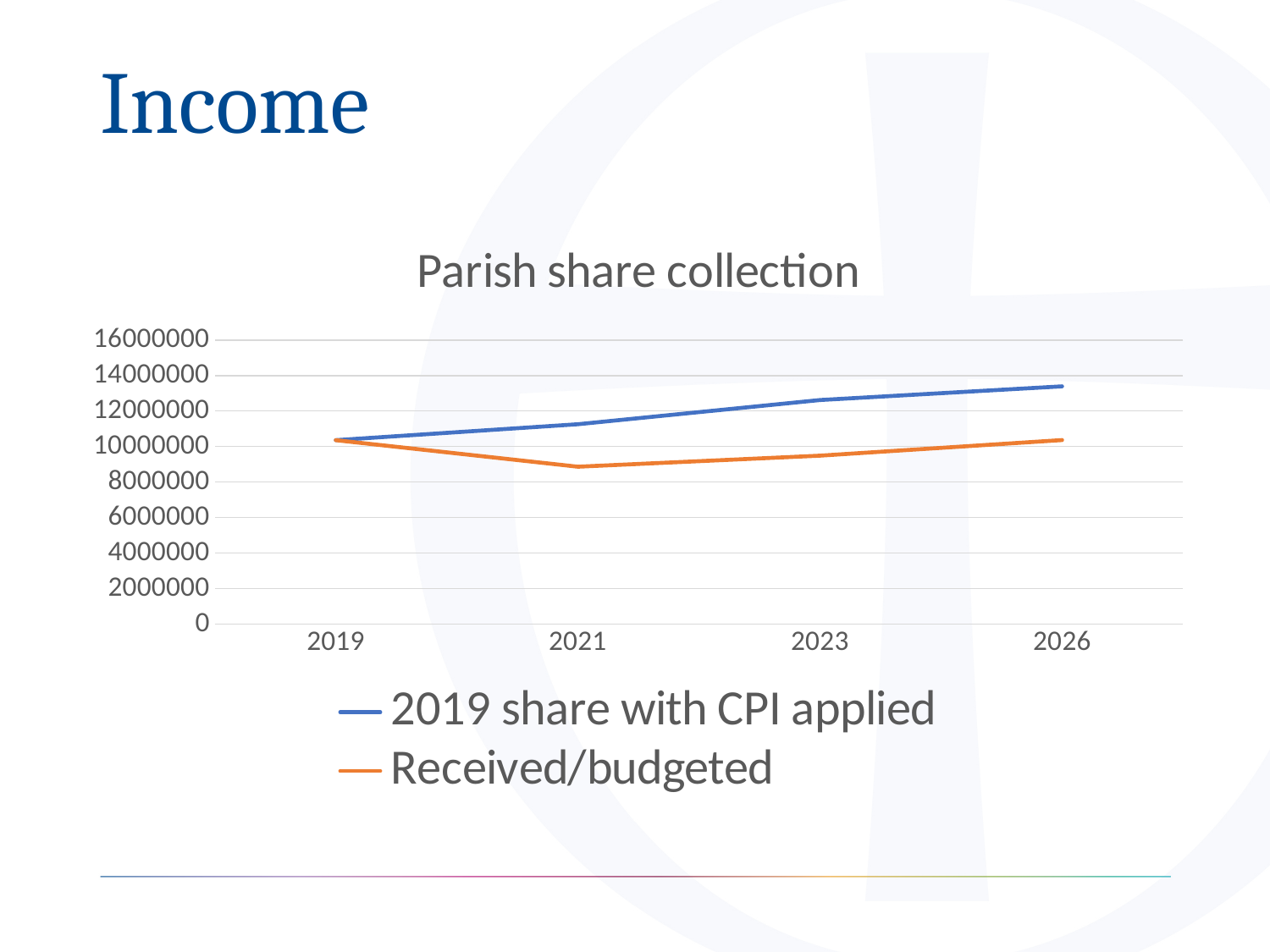
How many years are shown on the x axis? 4 What kind of chart is shown on the slide? line chart Is the value for '2019 share with CPI applied' in 2026 greater or less than 12000000? greater Is the value for 'Received/budgeted' in 2021 greater or less than 10000000? less How many series does the legend list? 2 Which series is drawn in orange? Received/budgeted In 2026, which series has the larger value, '2019 share with CPI applied' or 'Received/budgeted'? 2019 share with CPI applied Is the value for '2019 share with CPI applied' in 2021 greater or less than 10000000? greater Does the '2019 share with CPI applied' series rise or fall from 2019 to 2026? rise What is the title of the chart? Parish share collection In which year is the '2019 share with CPI applied' series highest? 2026 In which year is the 'Received/budgeted' series lowest? 2021